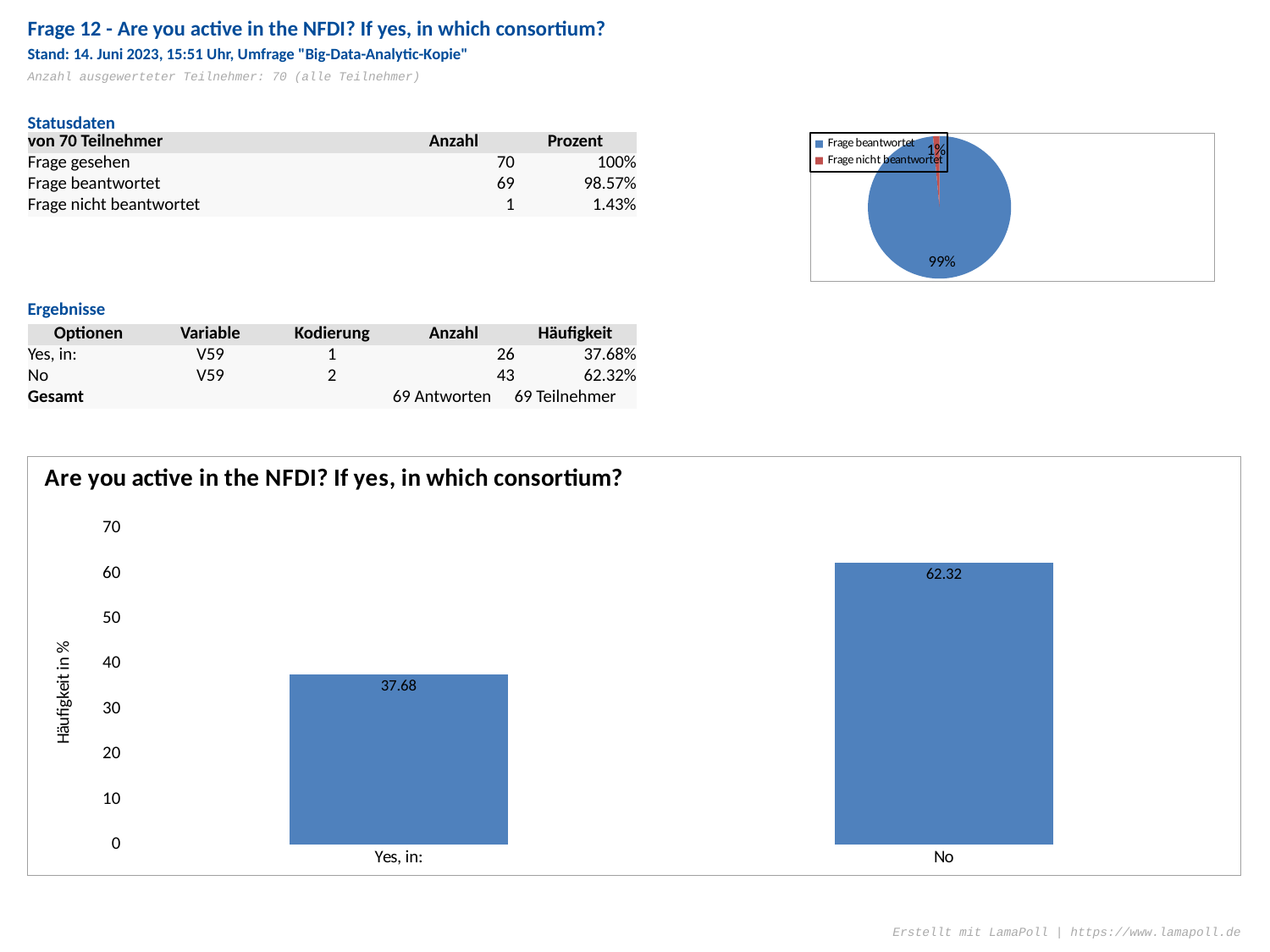
In the bar chart 'Are you active in the NFDI? If yes, in which consortium?', which category has the highest value? No In the bar chart 'Are you active in the NFDI? If yes, in which consortium?', what is the difference between the values for 'No' and 'Yes, in:'? 24.64 How many entries does the legend of the pie chart at the top right of the slide list? 2 In the bar chart 'Are you active in the NFDI? If yes, in which consortium?', which category has the lowest value? Yes, in: What kind of chart is the chart titled 'Are you active in the NFDI? If yes, in which consortium?'? bar chart In the bar chart 'Are you active in the NFDI? If yes, in which consortium?', how many categories are shown on the x axis? 2 In the bar chart 'Are you active in the NFDI? If yes, in which consortium?', what is the value for 'No'? 62.32 In the bar chart 'Are you active in the NFDI? If yes, in which consortium?', is the value for 'Yes, in:' greater or less than 40? less In the bar chart 'Are you active in the NFDI? If yes, in which consortium?', what is the value for 'Yes, in:'? 37.68 In the pie chart at the top right of the slide, what share is shown for 'Frage nicht beantwortet'? 1% In the bar chart 'Are you active in the NFDI? If yes, in which consortium?', what is the label of the y axis? Häufigkeit in % In the pie chart at the top right of the slide, what share is shown for 'Frage beantwortet'? 99%